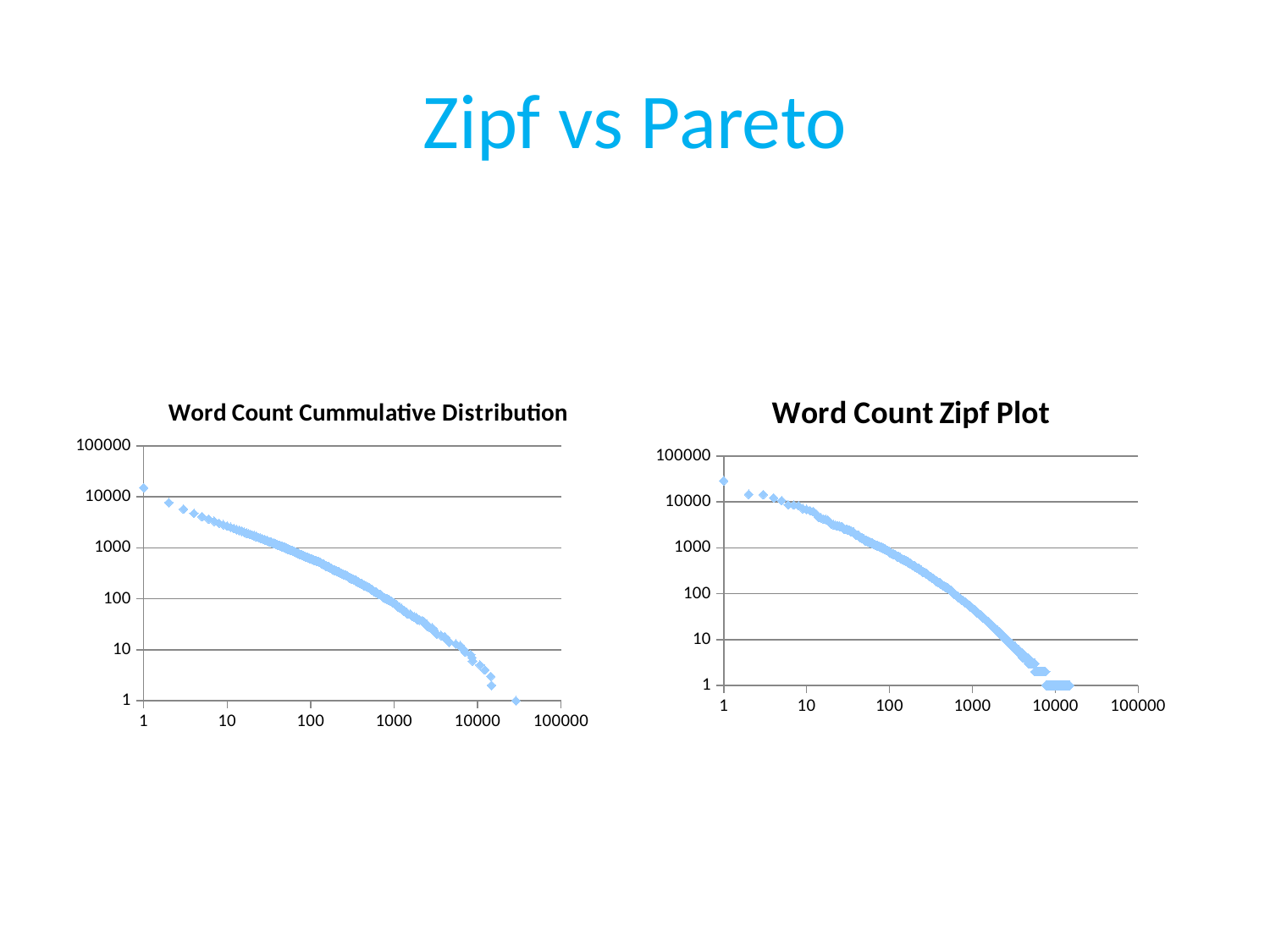
In the "Word Count Cummulative Distribution" chart, do the values rise or fall as the x axis increases? fall What kind of chart is the "Word Count Zipf Plot"? scatter chart In the "Word Count Cummulative Distribution" chart, is the value of the first point at x = 1 greater or less than 10000? greater What kind of chart is the "Word Count Cummulative Distribution" chart? scatter chart In the "Word Count Zipf Plot", do the values rise or fall as the x axis increases? fall In the "Word Count Zipf Plot", is the value of the first point at x = 1 greater or less than 10000? greater In the "Word Count Cummulative Distribution" chart, is the value of the last point (near x = 30000) greater or less than 10? less What is the title of the chart on the left of the slide? Word Count Cummulative Distribution How many charts are shown on the slide? 2 What is the highest value shown on the y axis of the "Word Count Zipf Plot"? 100000